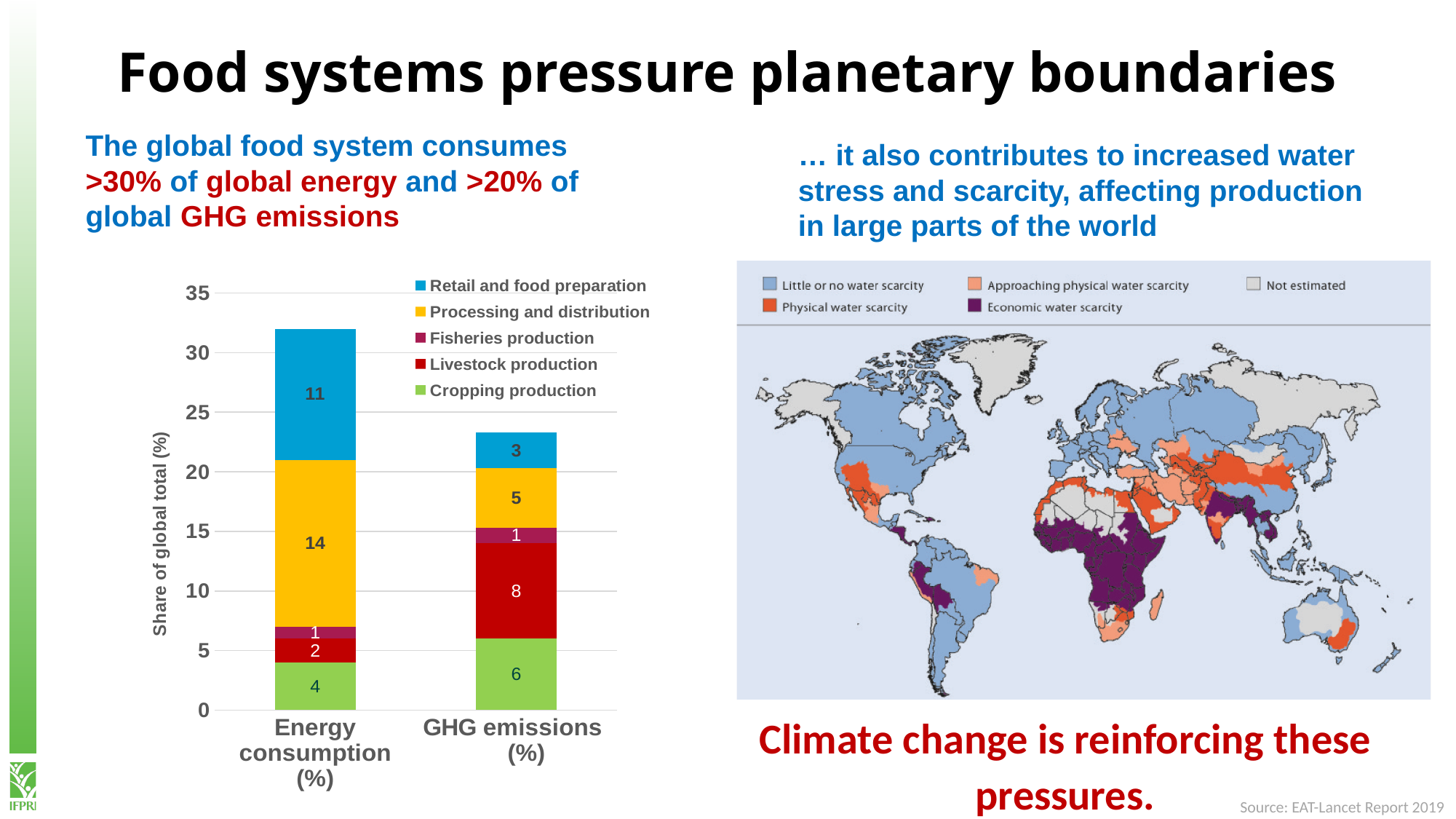
In the stacked bar chart, what is the value for Livestock production in the GHG emissions (%) bar? 8 In the stacked bar chart, what is the total of the GHG emissions (%) bar? 23 In the stacked bar chart, what is the value for Retail and food preparation in the Energy consumption (%) bar? 11 In the stacked bar chart, which series has the largest segment in the GHG emissions (%) bar? Livestock production In the stacked bar chart, which series has the largest segment in the Energy consumption (%) bar? Processing and distribution In the stacked bar chart, what is the difference between the Livestock production values for GHG emissions (%) and Energy consumption (%)? 6 In the stacked bar chart, is the Cropping production value larger for Energy consumption (%) or GHG emissions (%)? GHG emissions (%) In the stacked bar chart, what is the total of the Energy consumption (%) bar? 32 In the stacked bar chart, what is the value for Cropping production in the GHG emissions (%) bar? 6 In the stacked bar chart, what is the value for Processing and distribution in the Energy consumption (%) bar? 14 How many series does the legend of the stacked bar chart list? 5 What type of chart is shown on the left of the slide? Stacked bar chart